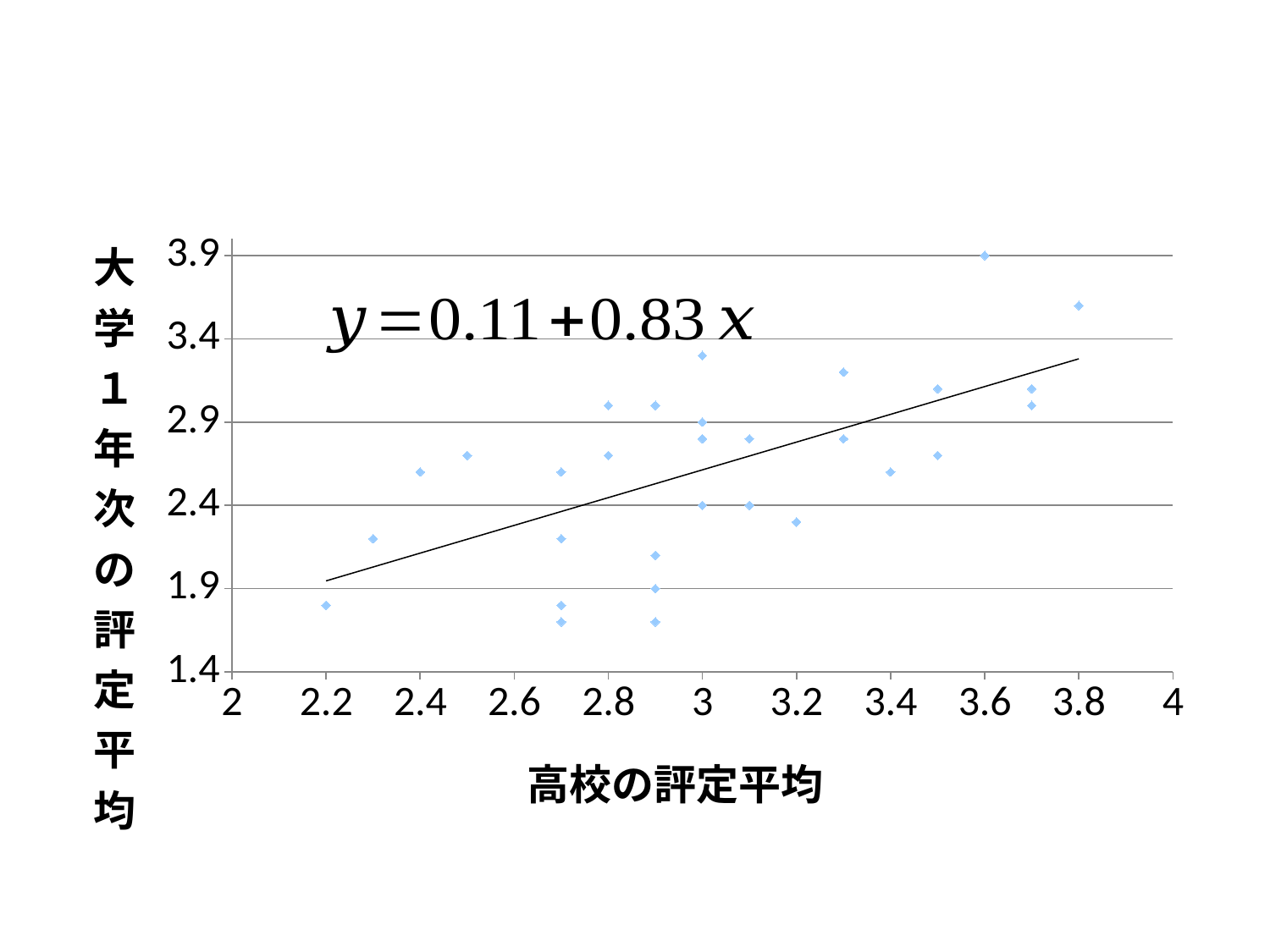
What regression equation is printed on the chart? y = 0.11 + 0.83x Which has the larger y value: the point at x = 3.8 or the point at x = 2.2? the point at x = 3.8 Is the y value of the point at x = 3.2 greater or less than 2.4? less At which x value (高校の評定平均) does the highest plotted point occur? 3.6 Is the y value of the point at x = 2.3 greater or less than 2.4? less Is the y value of the point at x = 2.2 greater or less than 1.9? less What is the label of the x axis? 高校の評定平均 What is the lowest value shown on the y axis? 1.4 What is the highest y value (大学1年次の評定平均) among the plotted points? 3.9 What kind of chart is shown on the slide? scatter plot Do the plotted values generally rise or fall as the high school GPA (x axis) increases? rise